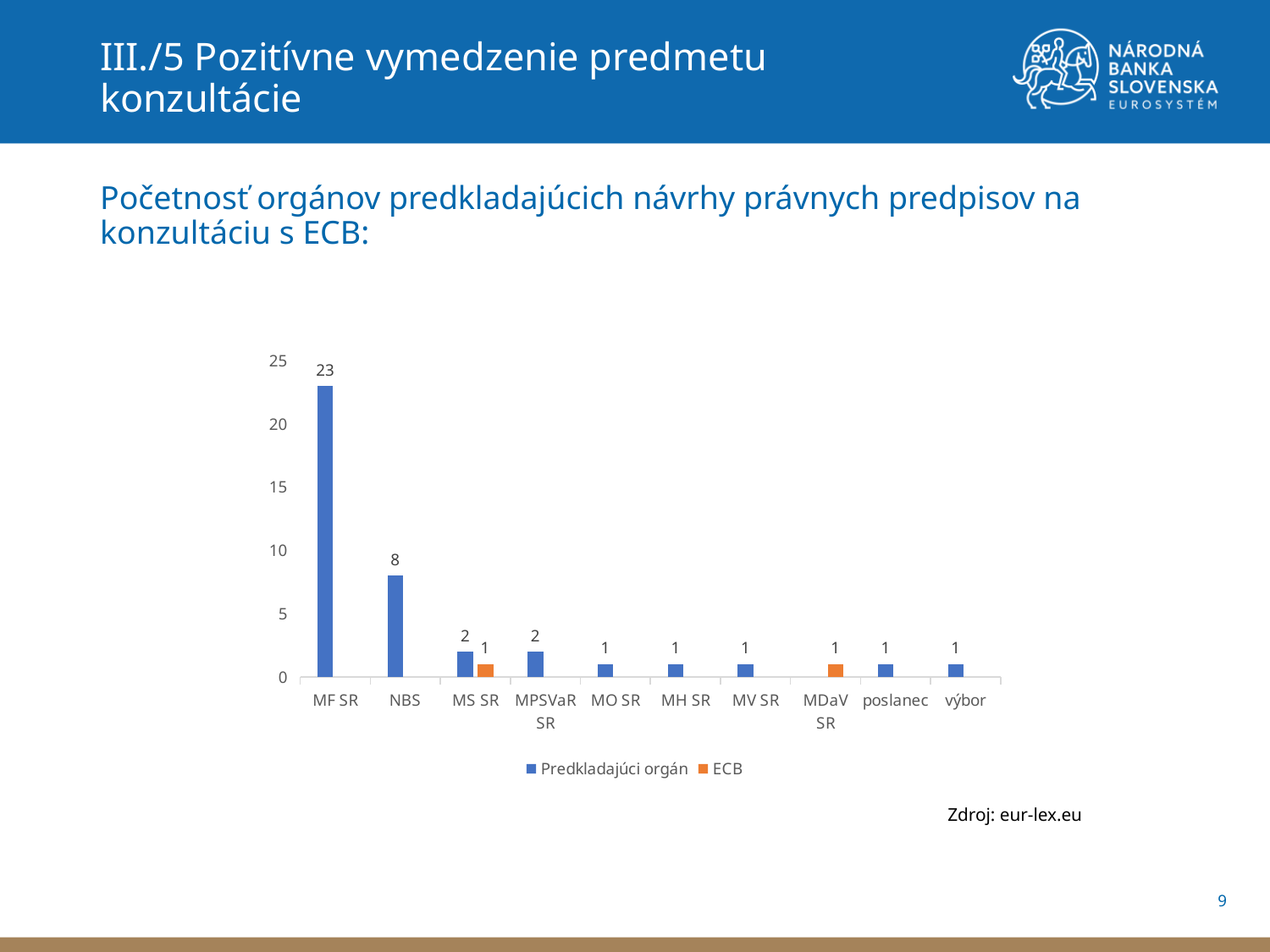
What is the ECB value for MS SR? 1 How many categories are shown on the x axis? 10 What is the value for MF SR in the Predkladajúci orgán series? 23 Which series is shown in orange in the legend? ECB How many series does the legend list? 2 What kind of chart is shown on the slide? bar chart What is the value for NBS in the Predkladajúci orgán series? 8 What is the difference between the Predkladajúci orgán values for MF SR and NBS? 15 What is the value for MPSVaR SR in the Predkladajúci orgán series? 2 Is the value for MF SR greater or less than 20? greater Which category has the highest value in the Predkladajúci orgán series? MF SR Which is larger, the Predkladajúci orgán value for NBS or for MS SR? NBS